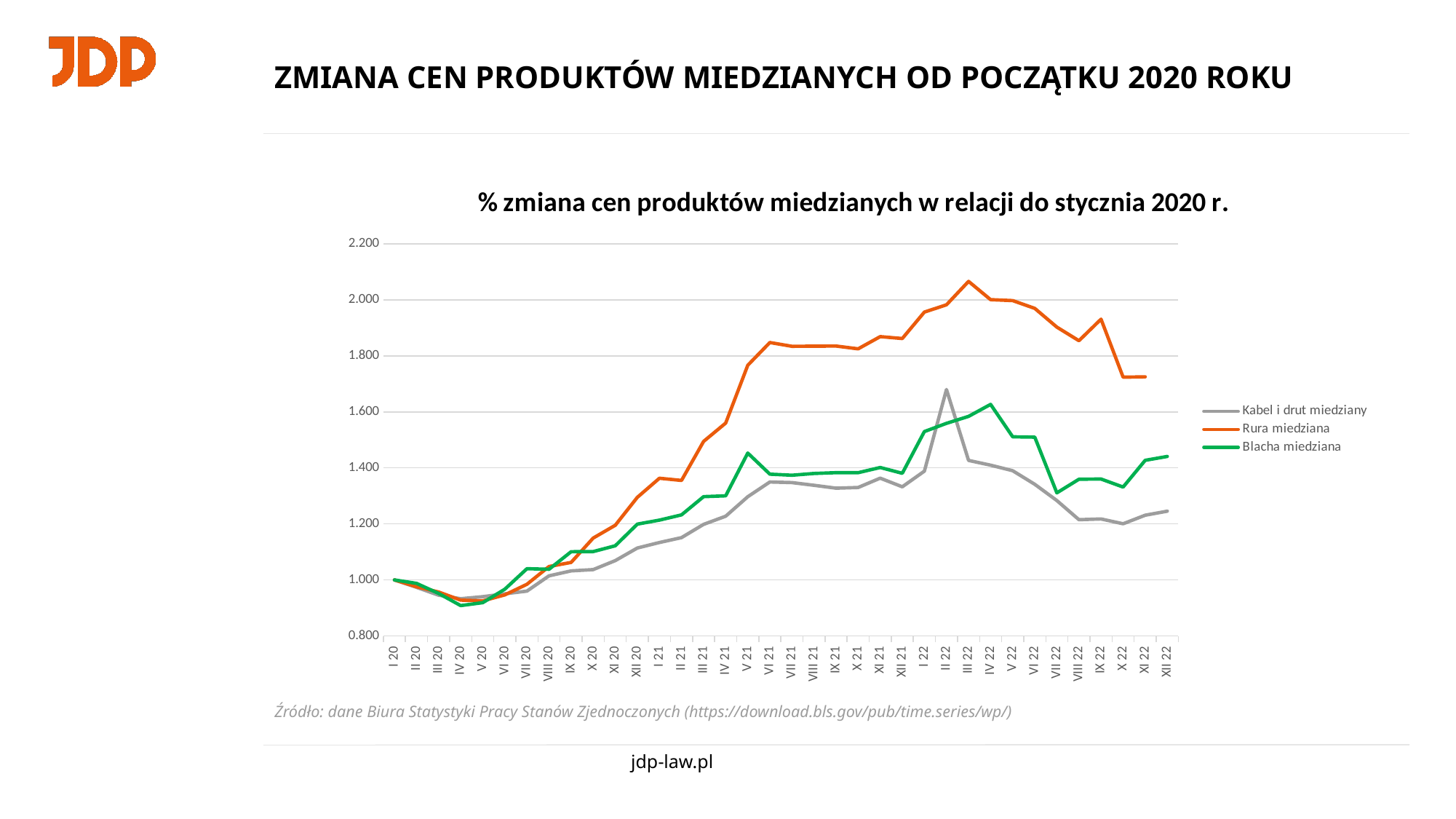
Is the value for Blacha miedziana at VII 22 greater or less than 1.400? less What is the title of the chart? % zmiana cen produktów miedzianych w relacji do stycznia 2020 r. What colour is the line for Rura miedziana? orange Is the value for Kabel i drut miedziany at XII 22 greater or less than 1.400? less Does the Rura miedziana line rise or fall between III 22 and XI 22? fall Is the value for Rura miedziana at III 22 greater or less than 2.000? greater How many series does the legend list? 3 How many monthly points are shown along the x axis? 36 What kind of chart is shown on the slide? line chart Which series reaches the highest value on the chart? Rura miedziana